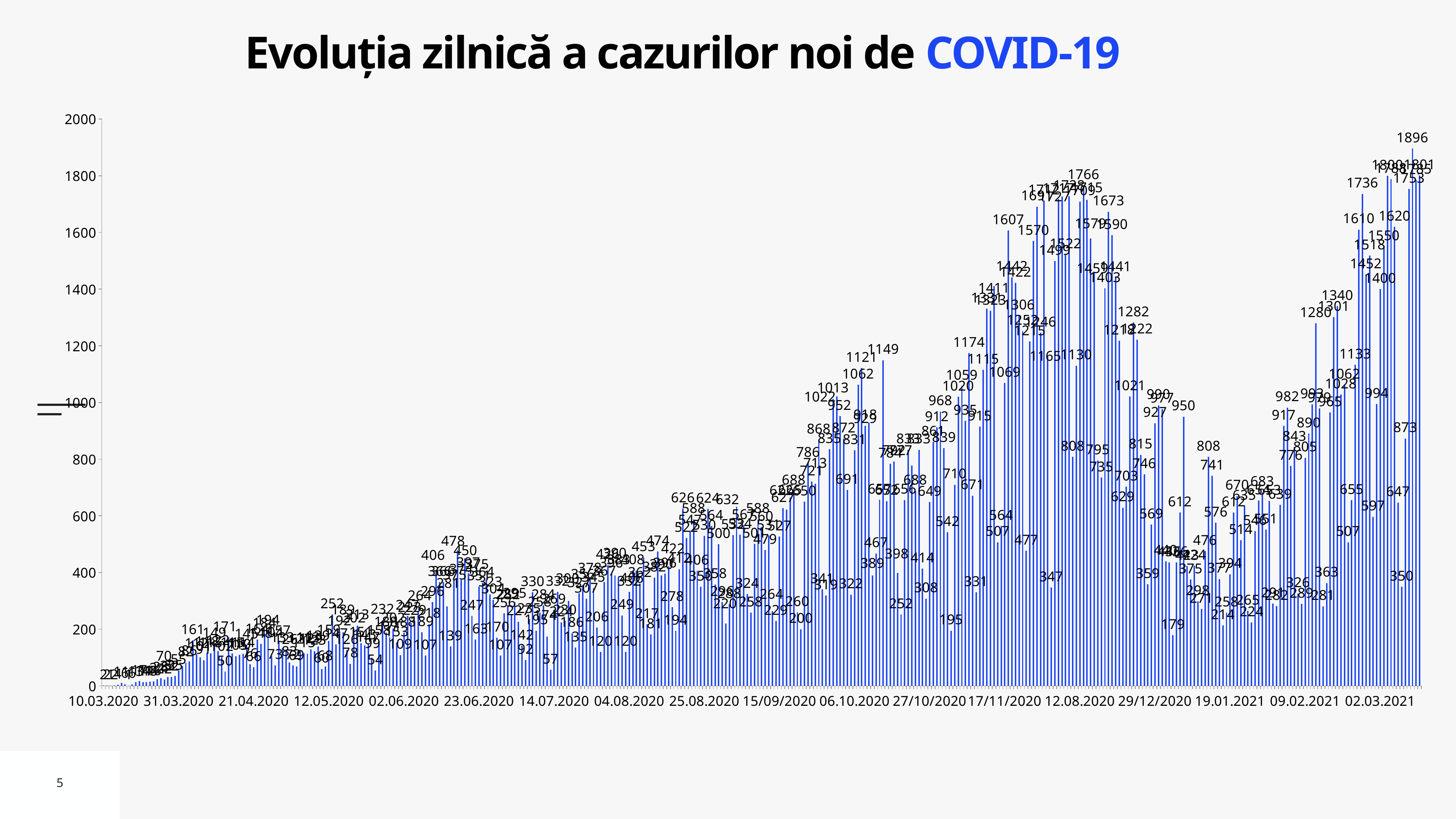
What is the highest value labelled on the chart? 1896 What is the difference between the highest value on the chart (1896) and the peak of the late-2020 wave (1766)? 130 Overall, do the values rise or fall from 10.03.2020 to the end of the x axis? rise What kind of chart is shown on the slide? bar chart What is the first date label on the x axis? 10.03.2020 How many date labels are shown on the x axis? 18 What is the title of the chart? Evoluția zilnică a cazurilor noi de COVID-19 Which is larger: the peak value of the late-2020 wave (1766) or the last bar on the chart (1896)? 1896 What is the maximum value shown on the y axis? 2000 Is the value of the first bar on the chart (10.03.2020) greater or less than 200? less